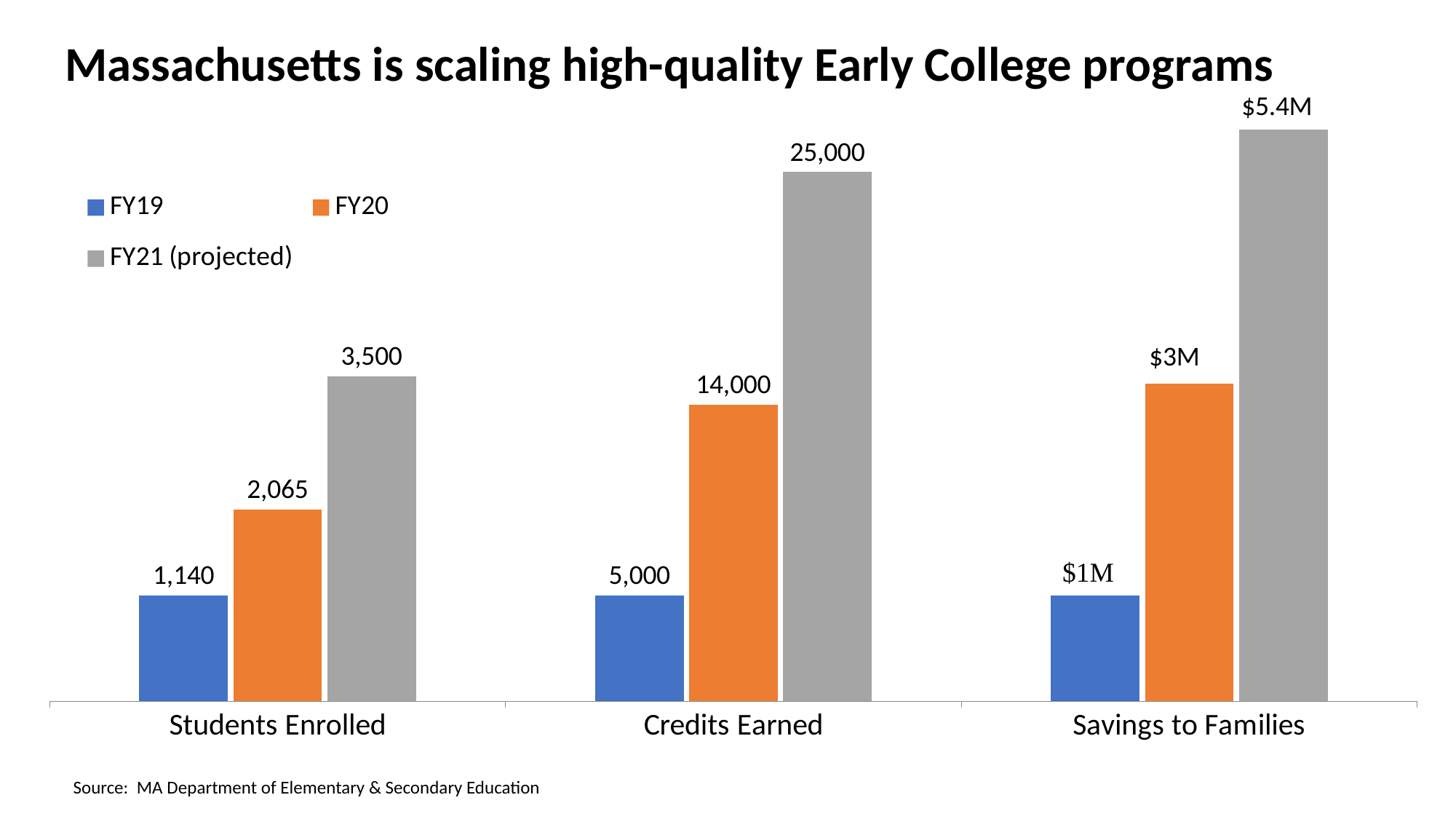
What is the FY21 (projected) value for Credits Earned? 25,000 Which series has the highest value for Credits Earned? FY21 (projected) What is the difference between the FY21 (projected) and FY19 values for Students Enrolled? 2,360 Which is larger for Savings to Families: the FY20 value or the FY19 value? FY20 Which series has the lowest value for Students Enrolled? FY19 What is the FY20 value for Students Enrolled? 2,065 What is the FY19 value for Savings to Families? $1M What is the FY21 (projected) value for Savings to Families? $5.4M How many categories are shown on the x axis? 3 What kind of chart is shown on the slide? Bar chart How many series does the legend list? 3 What is the difference between the FY20 and FY19 values for Credits Earned? 9,000